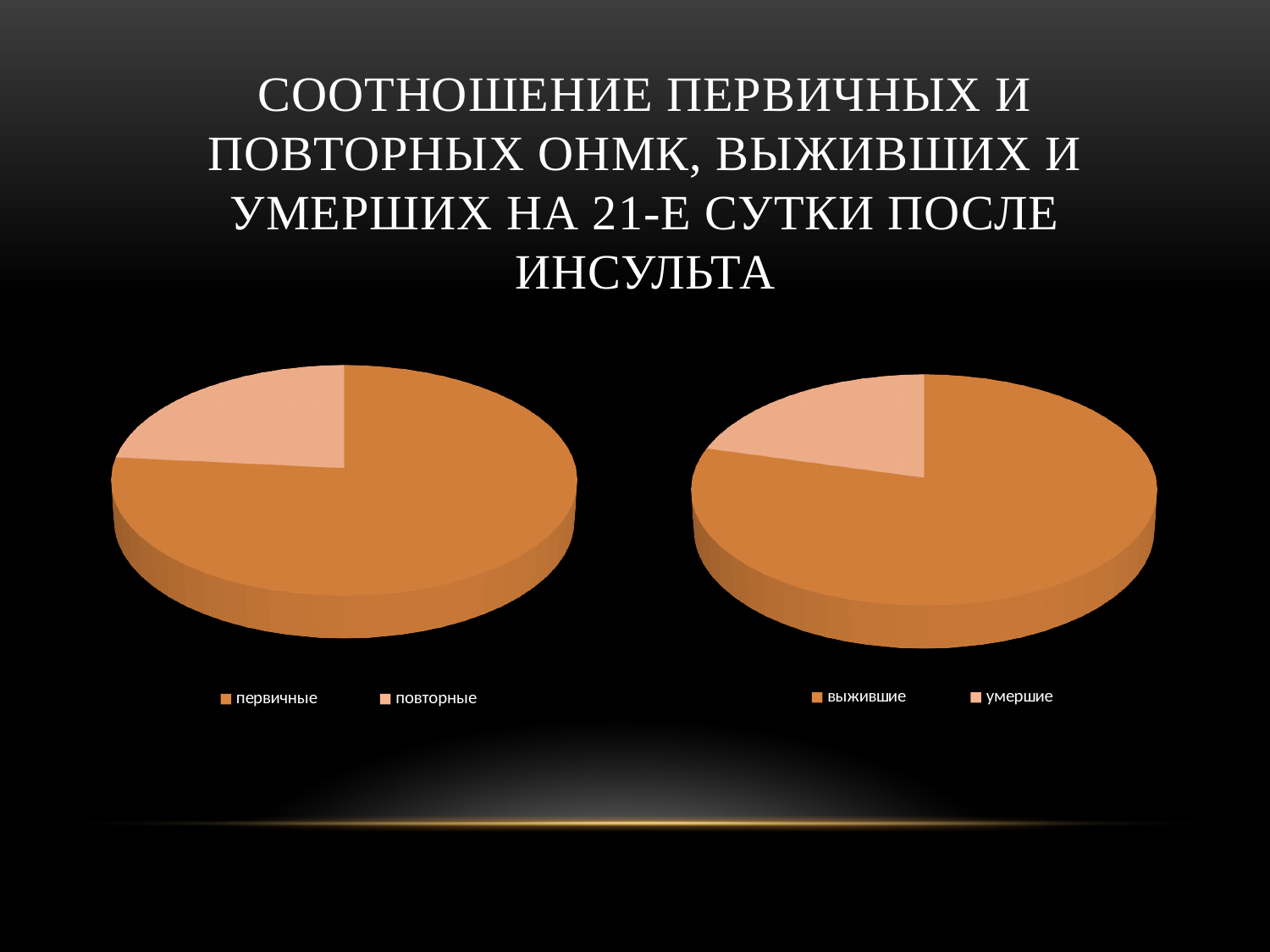
What kind of chart is the right chart on the slide? pie chart In the right pie chart, which category has the smallest slice? умершие In the left pie chart, which slice is larger: первичные or повторные? первичные What kind of chart is the left chart on the slide? pie chart In the left pie chart, which category has the smallest slice? повторные How many slices does the left pie chart have? 2 What are the legend entries of the right pie chart? выжившие, умершие In the right pie chart, which slice is larger: выжившие or умершие? выжившие In the left pie chart, which category has the largest slice? первичные In the right pie chart, which category has the largest slice? выжившие What are the legend entries of the left pie chart? первичные, повторные How many slices does the right pie chart have? 2